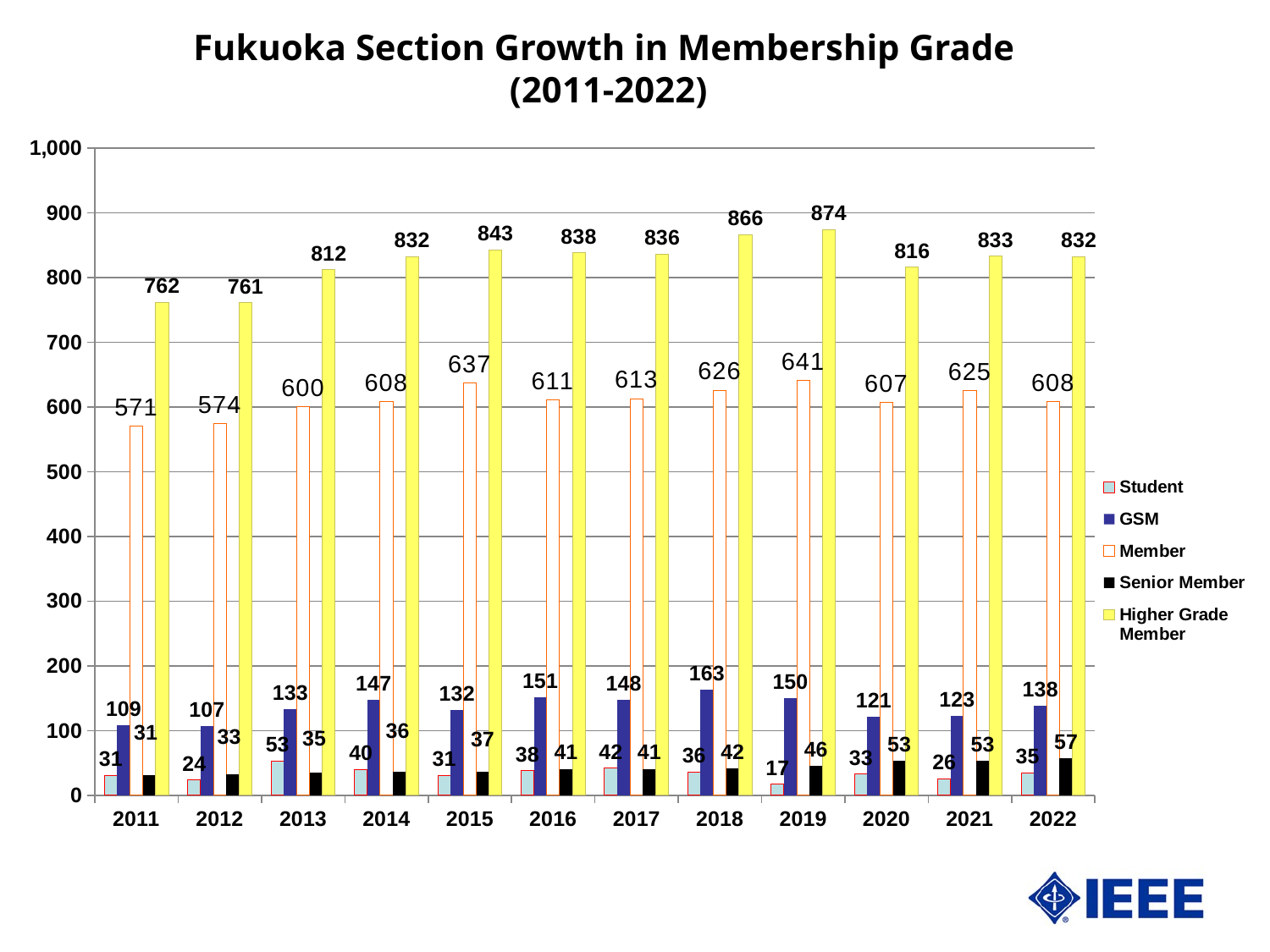
In which year is the Higher Grade Member value highest? 2019 Does the Senior Member value rise or fall from 2011 to 2022? Rise How many series does the legend list? 5 What is the Member value for 2015? 637 What is the difference between the Higher Grade Member values for 2019 and 2011? 112 In which year is the Student value lowest? 2019 What is the Higher Grade Member value for 2019? 874 How many years are shown on the x axis? 12 What is the Student value for 2013? 53 Which is larger, the Member value for 2021 or the Member value for 2020? 2021 What is the GSM value for 2018? 163 What kind of chart is shown on the slide? Bar chart